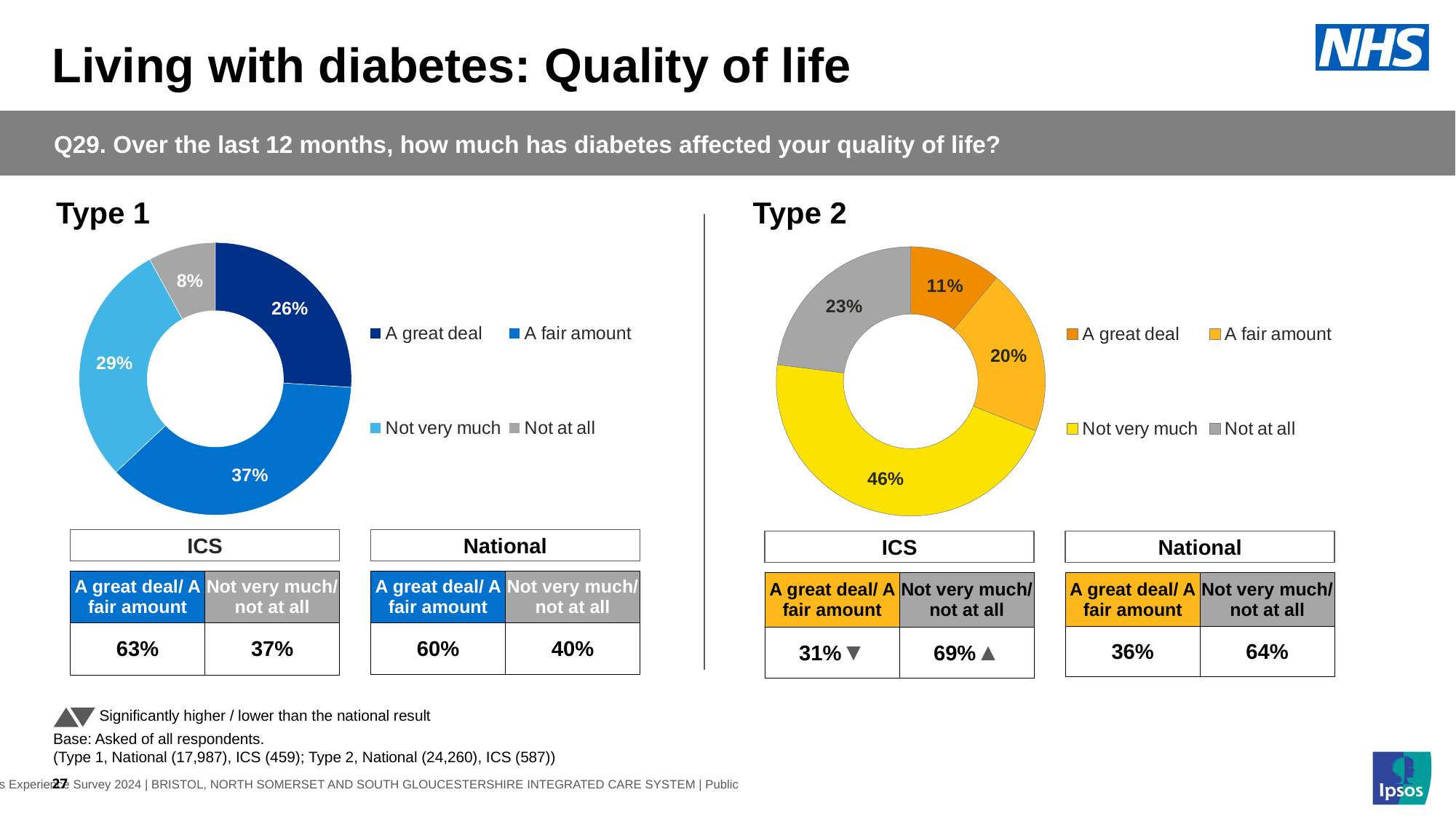
In the Type 2 chart, what percentage of respondents said 'Not very much'? 46% In the Type 1 chart, which response category has the largest share? A fair amount In the Type 2 chart, which response category has the smallest share? A great deal How many entries does the legend of the Type 1 chart list? 4 In the Type 1 chart, what percentage said 'Not at all'? 8% In the Type 2 chart, what is the combined share of 'A great deal' and 'A fair amount'? 31% In the Type 1 chart, what percentage of respondents said diabetes affected their quality of life 'A fair amount'? 37% How many response categories are shown in the Type 1 chart? 4 In the Type 2 chart, which is larger: 'Not at all' or 'A fair amount'? Not at all In the Type 1 chart, what is the difference between the 'A fair amount' and 'A great deal' shares? 11 percentage points What kind of chart is used for the Type 2 data? Doughnut (pie) chart In the Type 2 chart, what percentage said 'A great deal'? 11%